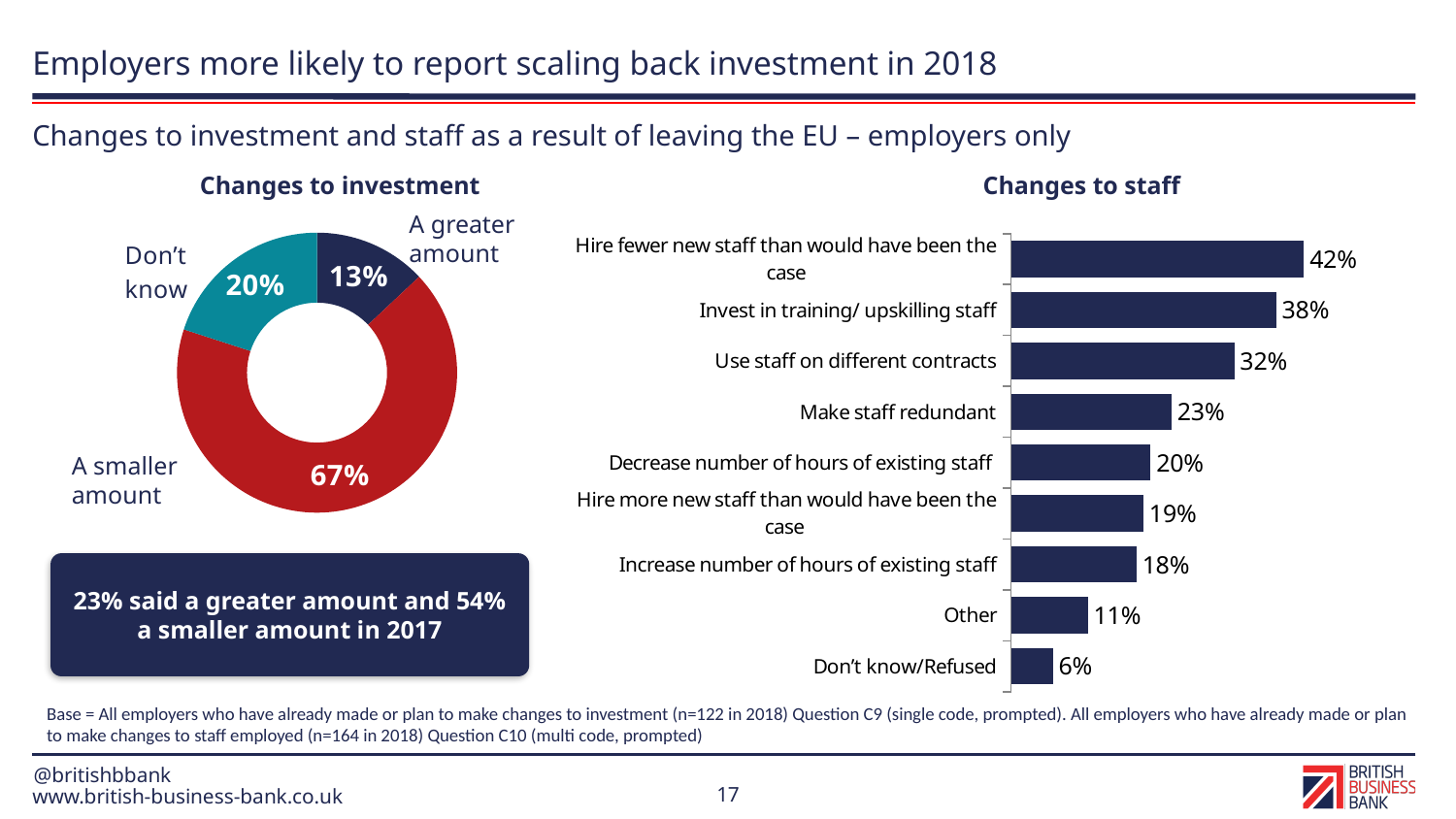
In the 'Changes to staff' chart, how many categories are shown? 9 In the 'Changes to investment' chart, which category has the smallest share? A greater amount In the 'Changes to investment' chart, which category has the largest share? A smaller amount In the 'Changes to staff' chart, what is the difference between 'Invest in training/ upskilling staff' and 'Use staff on different contracts'? 6% What kind of chart is the 'Changes to investment' chart? Pie chart (doughnut) In the 'Changes to investment' chart, what share of employers said a greater amount? 13% In the 'Changes to staff' chart, which is larger: 'Decrease number of hours of existing staff' or 'Increase number of hours of existing staff'? Decrease number of hours of existing staff In the 'Changes to staff' chart, what is the value for 'Make staff redundant'? 23% In the 'Changes to staff' chart, which category has the lowest value? Don't know/Refused In the 'Changes to staff' chart, which category has the highest value? Hire fewer new staff than would have been the case In the 'Changes to investment' chart, what share of employers said a smaller amount? 67% In the 'Changes to investment' chart, how many categories are shown? 3